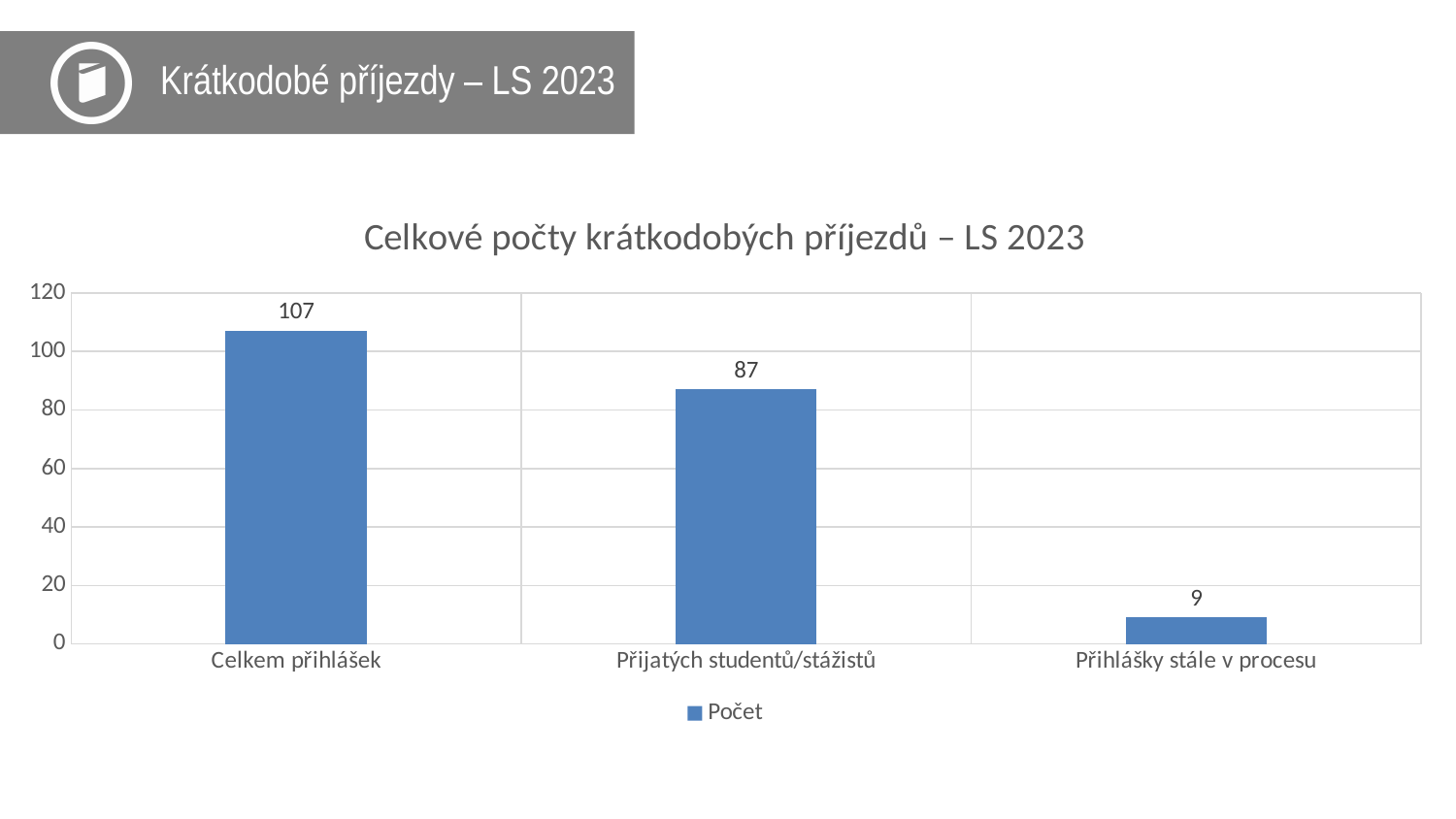
What kind of chart is shown? bar chart What is the value for Přijatých studentů/stážistů? 87 How many categories are shown on the chart? 3 Is the value for Přijatých studentů/stážistů greater or less than 80? greater What is the title of the chart? Celkové počty krátkodobých příjezdů – LS 2023 Which category has the highest value? Celkem přihlášek Which is larger, Celkem přihlášek or Přijatých studentů/stážistů? Celkem přihlášek What is the difference between Přijatých studentů/stážistů and Přihlášky stále v procesu? 78 What is the value for Celkem přihlášek? 107 What is the value for Přihlášky stále v procesu? 9 Which category has the lowest value? Přihlášky stále v procesu What is the difference between Celkem přihlášek and Přijatých studentů/stážistů? 20